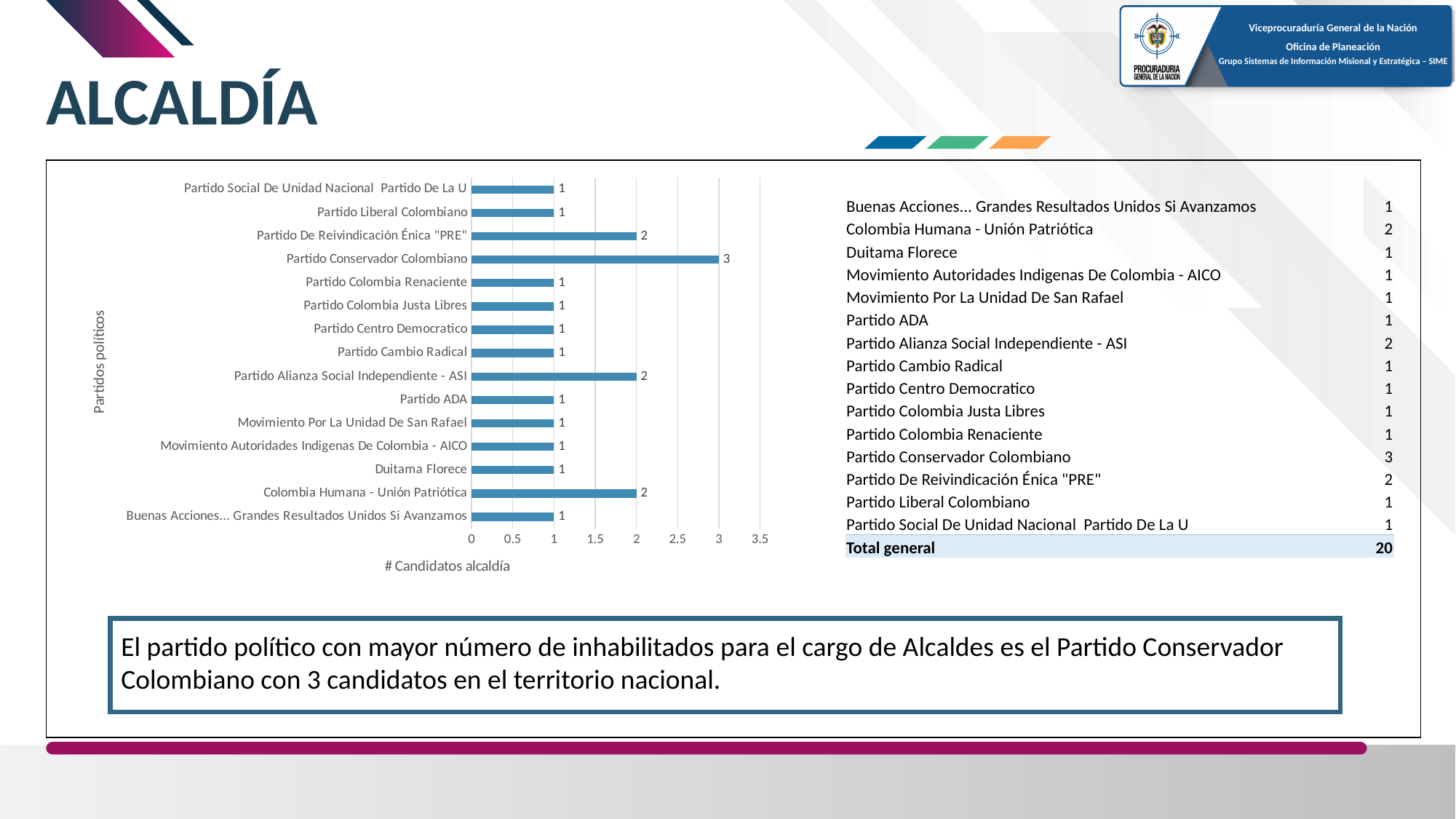
Which has a larger value, Partido De Reivindicación Énica "PRE" or Partido Cambio Radical? Partido De Reivindicación Énica "PRE" Is the value for Partido Conservador Colombiano greater or less than 2.5? greater What is the value for Partido Alianza Social Independiente - ASI in the bar chart? 2 What is the difference between the values for Partido Conservador Colombiano and Partido Liberal Colombiano? 2 What is the value for Colombia Humana - Unión Patriótica in the bar chart? 2 What is the value for Duitama Florece in the bar chart? 1 How many political parties (categories) are plotted in the bar chart? 15 What is the label of the vertical axis of the bar chart? Partidos políticos What type of chart is shown on the slide? bar chart Which party has the highest number of candidates in the bar chart? Partido Conservador Colombiano What is the label of the horizontal axis of the bar chart? # Candidatos alcaldía What is the value for Partido Conservador Colombiano in the bar chart? 3